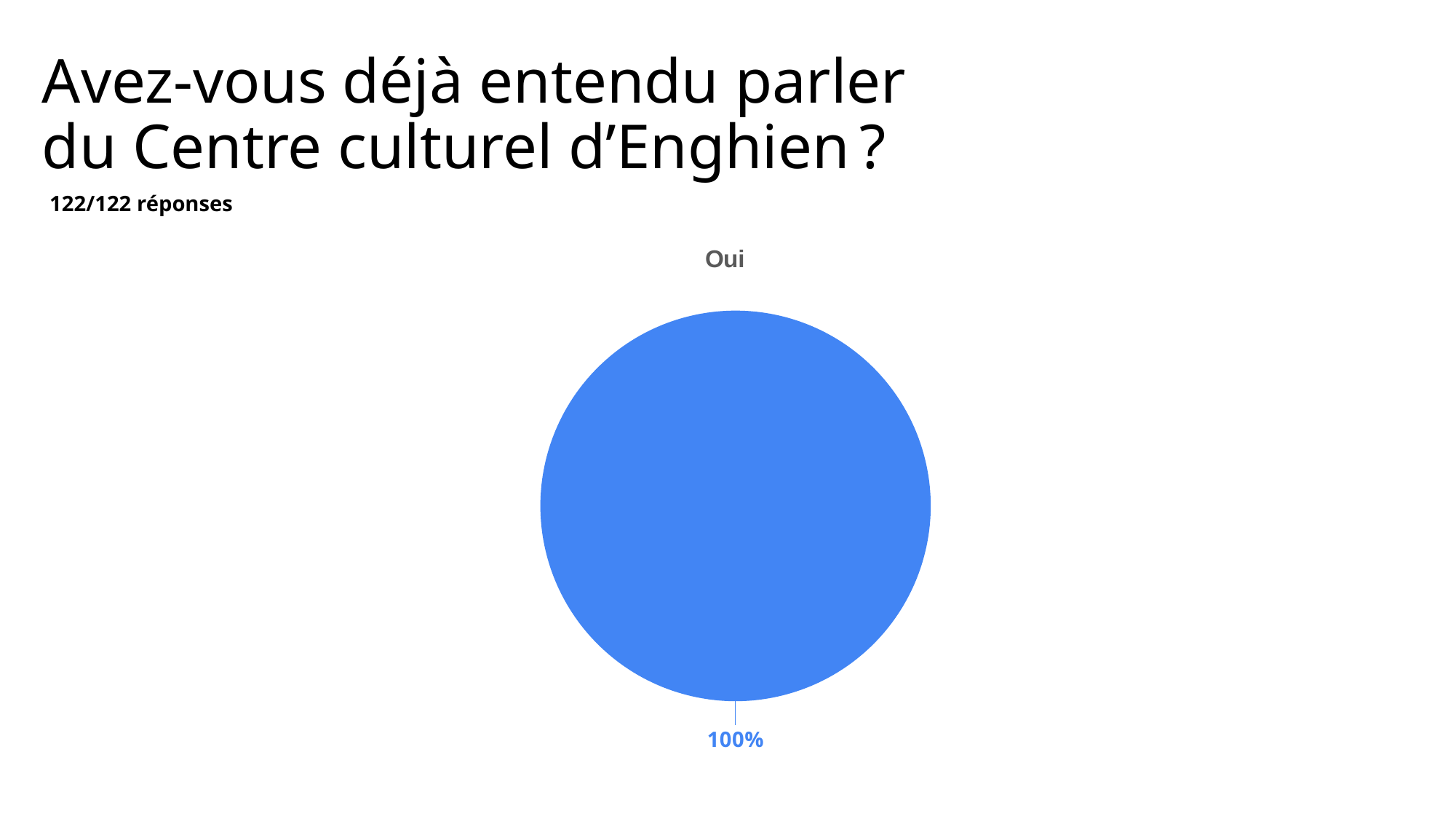
Which category is the largest slice of the pie chart? Oui What kind of chart is shown on the slide? pie chart Is the share for "Oui" greater or less than 50%? greater How many responses does the slide say the chart is based on? 122/122 réponses What is the label of the only slice in the pie chart? Oui What share of the pie does the "Oui" slice represent? 100% How many slices does the pie chart have? 1